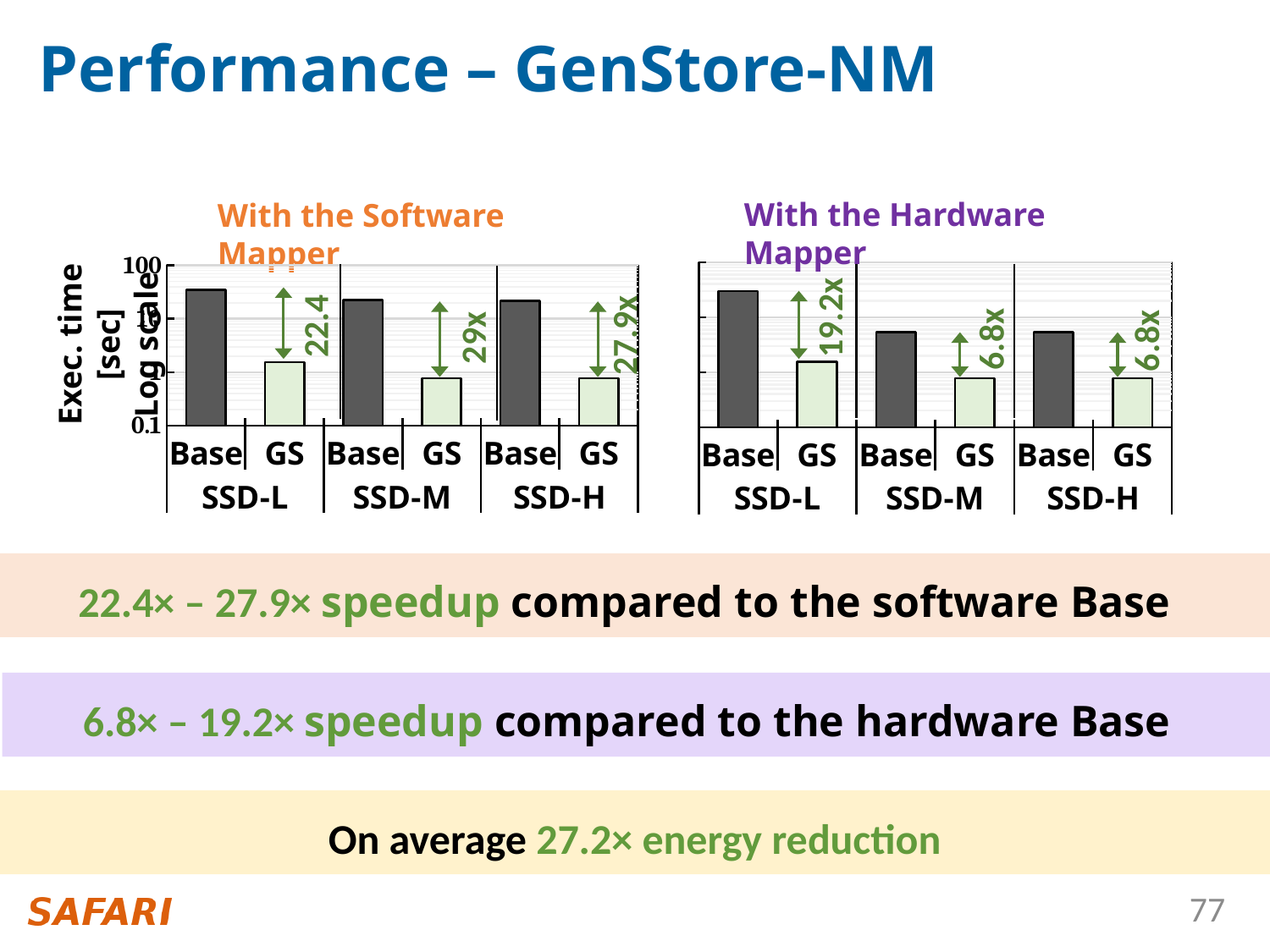
In the 'With the Hardware Mapper' chart, what speedup is annotated for SSD-L? 19.2x In the 'With the Software Mapper' chart, which SSD configuration has the highest annotated speedup? SSD-M What is the y-axis label of the 'With the Software Mapper' chart? Exec. time [sec] Log scale In the 'With the Software Mapper' chart, which bar is taller for SSD-L, Base or GS? Base In the 'With the Hardware Mapper' chart, which SSD configuration has the highest annotated speedup? SSD-L In the 'With the Software Mapper' chart, what speedup is annotated for SSD-H? 27.9x In the 'With the Hardware Mapper' chart, what speedup is annotated for SSD-H? 6.8x In the 'With the Software Mapper' chart, how many SSD configurations are shown on the x axis? 3 Which is larger, the annotated speedup for SSD-H in the 'With the Software Mapper' chart or in the 'With the Hardware Mapper' chart? With the Software Mapper In the 'With the Software Mapper' chart, what speedup is annotated for SSD-M? 29x What kind of chart is used in the 'With the Software Mapper' panel? bar chart In the 'With the Software Mapper' chart, is the Base execution time for SSD-L greater or less than 10? greater